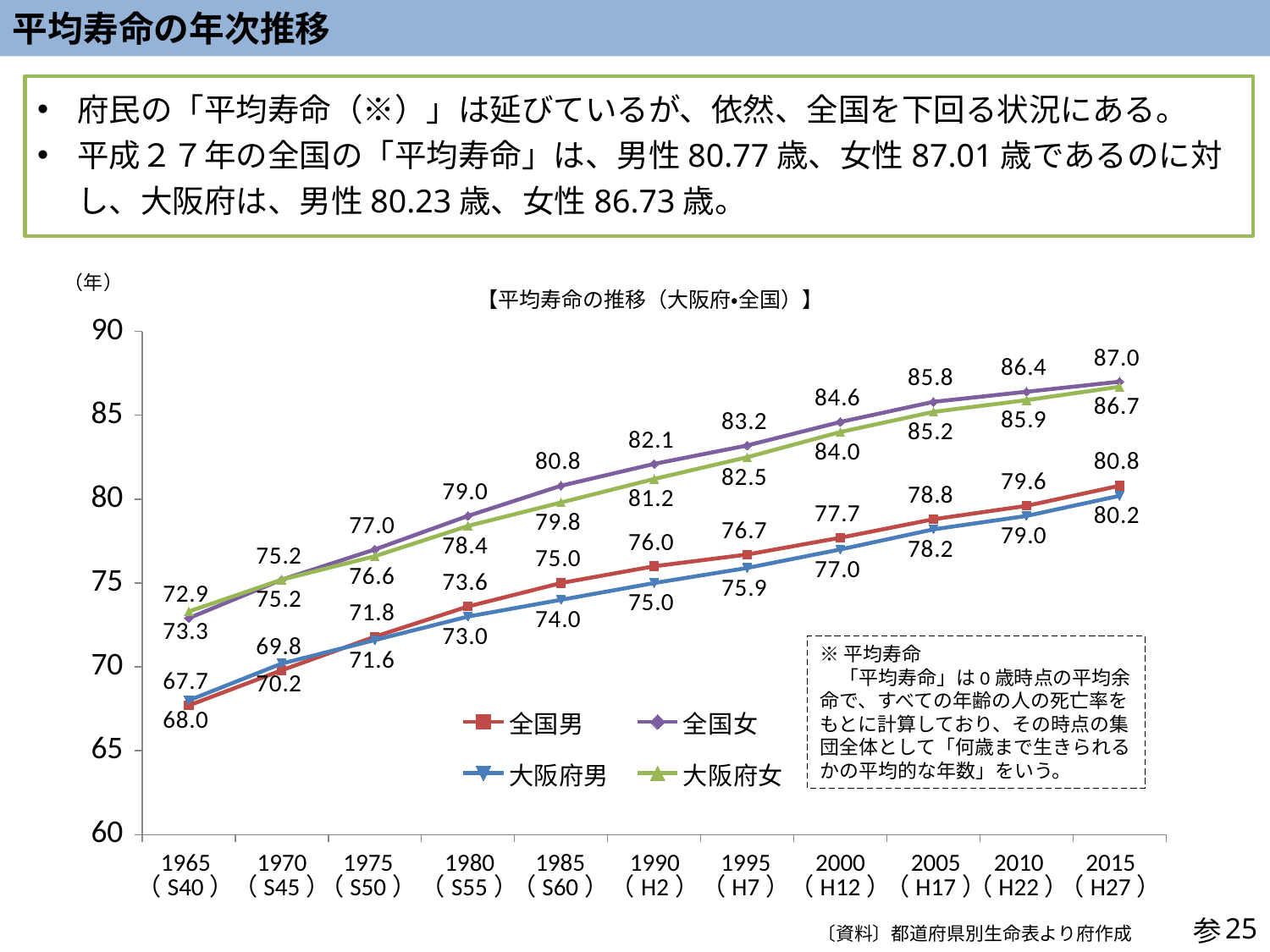
Which is larger in 2010 (H22), 全国男 or 大阪府男? 全国男 How many series does the legend list? 4 What is the difference between 全国男 and 大阪府男 in 2005 (H17)? 0.6 Which series has the highest value in 2015 (H27)? 全国女 What is the difference between 全国女 and 大阪府女 in 2015 (H27)? 0.3 Do the values for 大阪府女 rise or fall from 1965 to 2015? rise What is the value for 全国女 in 2015 (H27)? 87.0 What is the value for 大阪府男 in 2015 (H27)? 80.2 What is the value for 全国男 in 1990 (H2)? 76.0 What is the value for 大阪府女 in 2000 (H12)? 84.0 How many years are plotted along the x axis? 11 What type of chart is shown on the slide? line chart